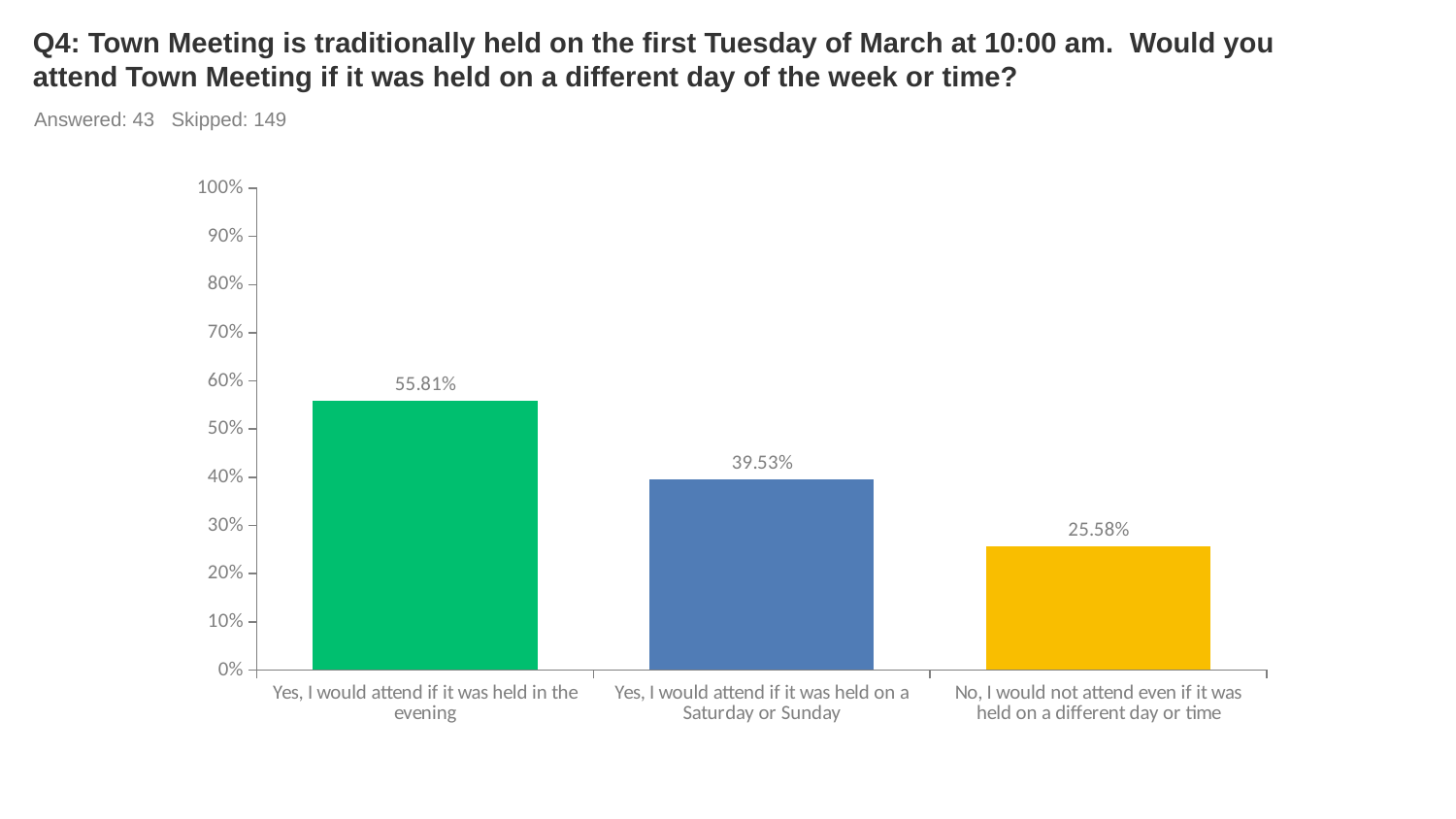
Which response option has the highest percentage? Yes, I would attend if it was held in the evening Is the value for 'Yes, I would attend if it was held in the evening' greater or less than 50%? greater What kind of chart is shown on the slide? Bar chart What is the difference in percentage points between the evening option and the Saturday or Sunday option? 16.28 Which is larger: the percentage for attending on a Saturday or Sunday, or the percentage for not attending at all? Yes, I would attend if it was held on a Saturday or Sunday What is the difference in percentage points between the Saturday or Sunday option and the 'No, I would not attend' option? 13.95 What percentage of respondents said they would attend if Town Meeting was held in the evening? 55.81% What percentage of respondents said they would attend if Town Meeting was held on a Saturday or Sunday? 39.53% How many response categories are shown in the chart? 3 What percentage of respondents said they would not attend even if Town Meeting was held on a different day or time? 25.58% Which response option has the lowest percentage? No, I would not attend even if it was held on a different day or time How many respondents answered this question according to the slide? 43